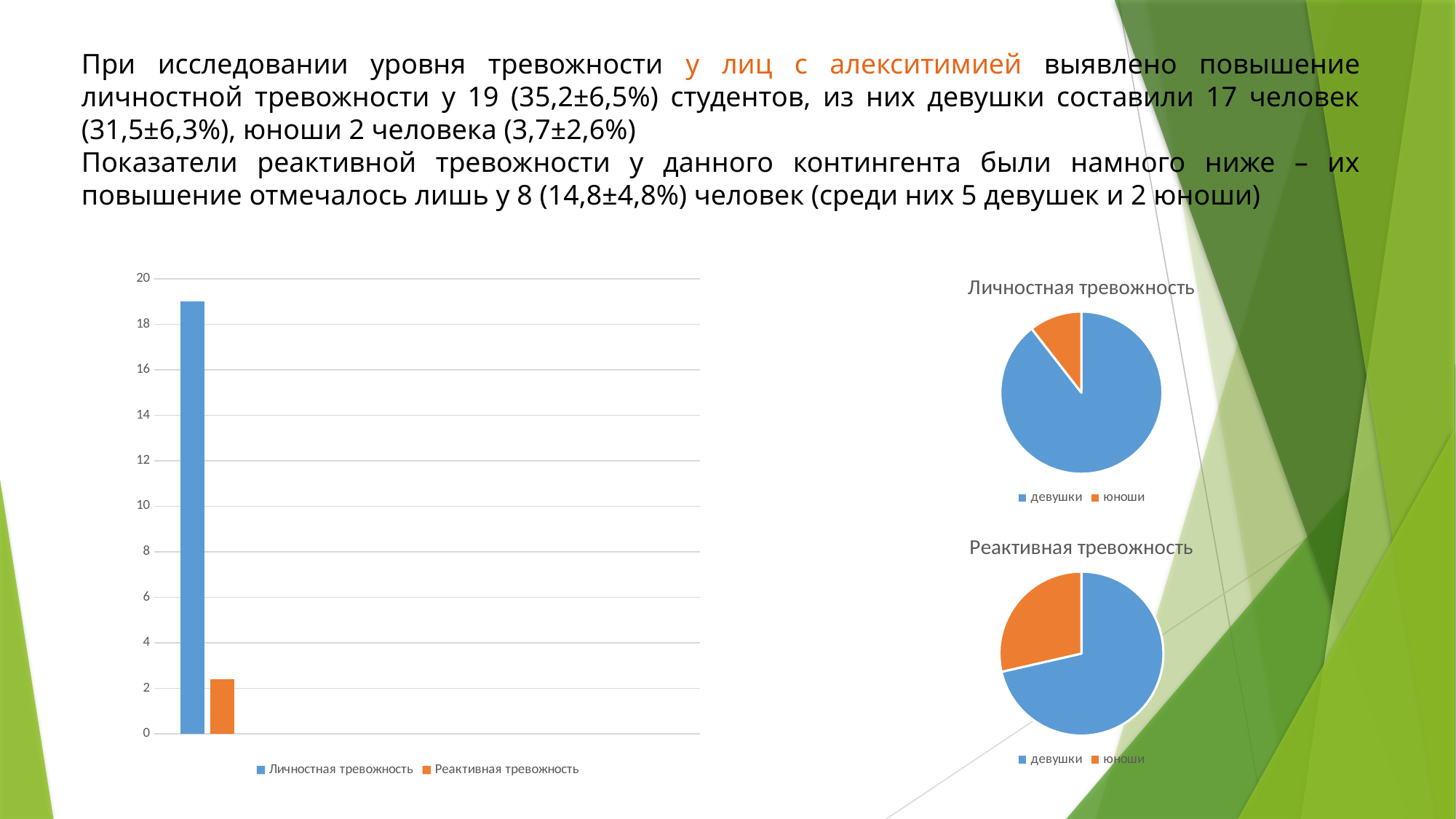
In the pie chart titled "Личностная тревожность", which slice is larger, девушки or юноши? девушки In the pie chart titled "Реактивная тревожность", which slice is the smallest? юноши In the pie chart titled "Личностная тревожность", what colour is the slice for юноши? orange What kind of chart is the chart on the left of the slide? bar chart How many slices does the pie chart titled "Реактивная тревожность" have? 2 In the bar chart on the left, how many series does the legend list? 2 In the bar chart on the left, is the value for Личностная тревожность greater or less than 18? greater What kind of chart is the chart titled "Личностная тревожность"? pie chart In the bar chart on the left, which series has the taller bar? Личностная тревожность What is the title of the lower pie chart on the right of the slide? Реактивная тревожность In the bar chart on the left, is the value for Реактивная тревожность greater or less than 4? less